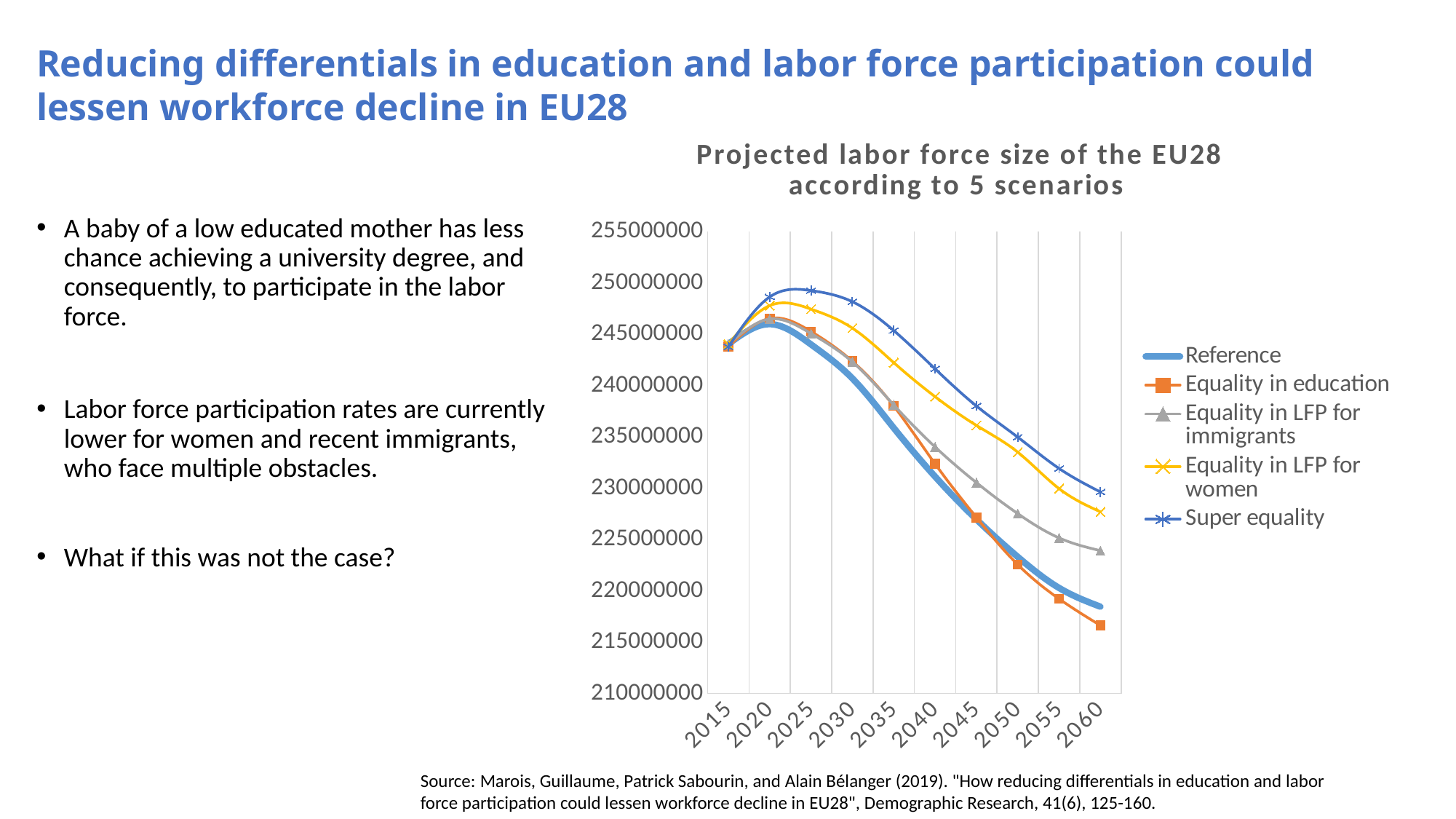
Is the value for Super equality in 2060 greater or less than 225000000? greater Which series is drawn with a thick blue line without markers? Reference Is the value for Equality in education in 2060 greater or less than 220000000? less How many series does the legend list? 5 Do the values for the Reference scenario rise or fall between 2025 and 2060? fall Which scenario has the lowest projected labor force size in 2060? Equality in education Which scenario has the highest projected labor force size in 2060? Super equality What kind of chart is shown on the slide? Line chart How many years are marked along the x axis? 10 In 2040, which is larger: Equality in LFP for women or Equality in education? Equality in LFP for women Is the value for Equality in LFP for women in 2060 greater or less than 225000000? greater What is the title of the chart? Projected labor force size of the EU28 according to 5 scenarios